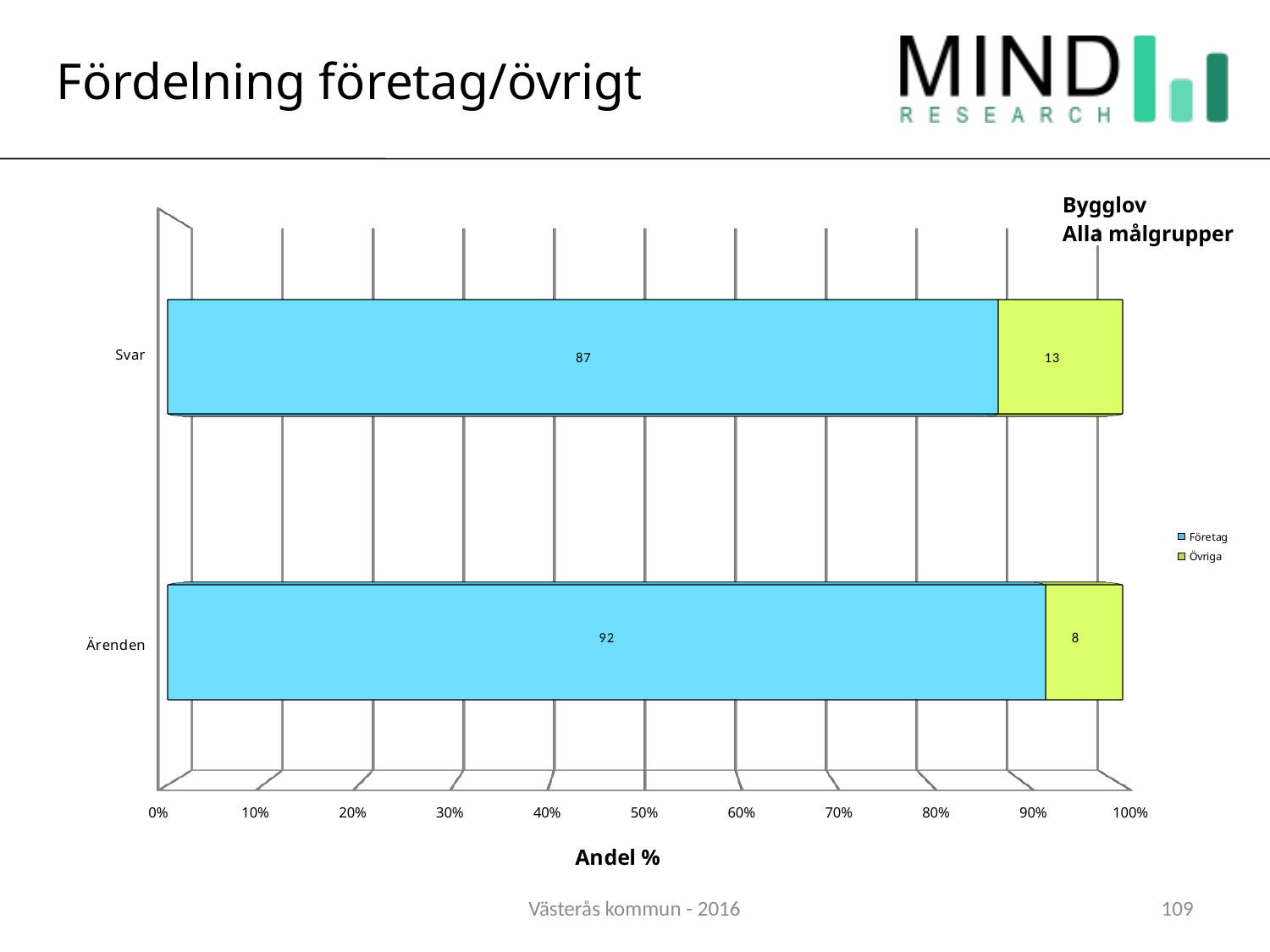
What is the label of the x axis? Andel % What kind of chart is shown on the slide? Stacked bar chart Which category has the lowest Övriga value? Ärenden What is the value for Företag in the Ärenden bar? 92 Which category has the higher Företag value, Svar or Ärenden? Ärenden What is the difference between the Företag values for Ärenden and Svar? 5 What is the value for Övriga in the Svar bar? 13 What is the value for Övriga in the Ärenden bar? 8 How many categories are shown on the y axis? 2 What is the total of the Svar stacked bar? 100 What is the value for Företag in the Svar bar? 87 How many series does the legend list? 2